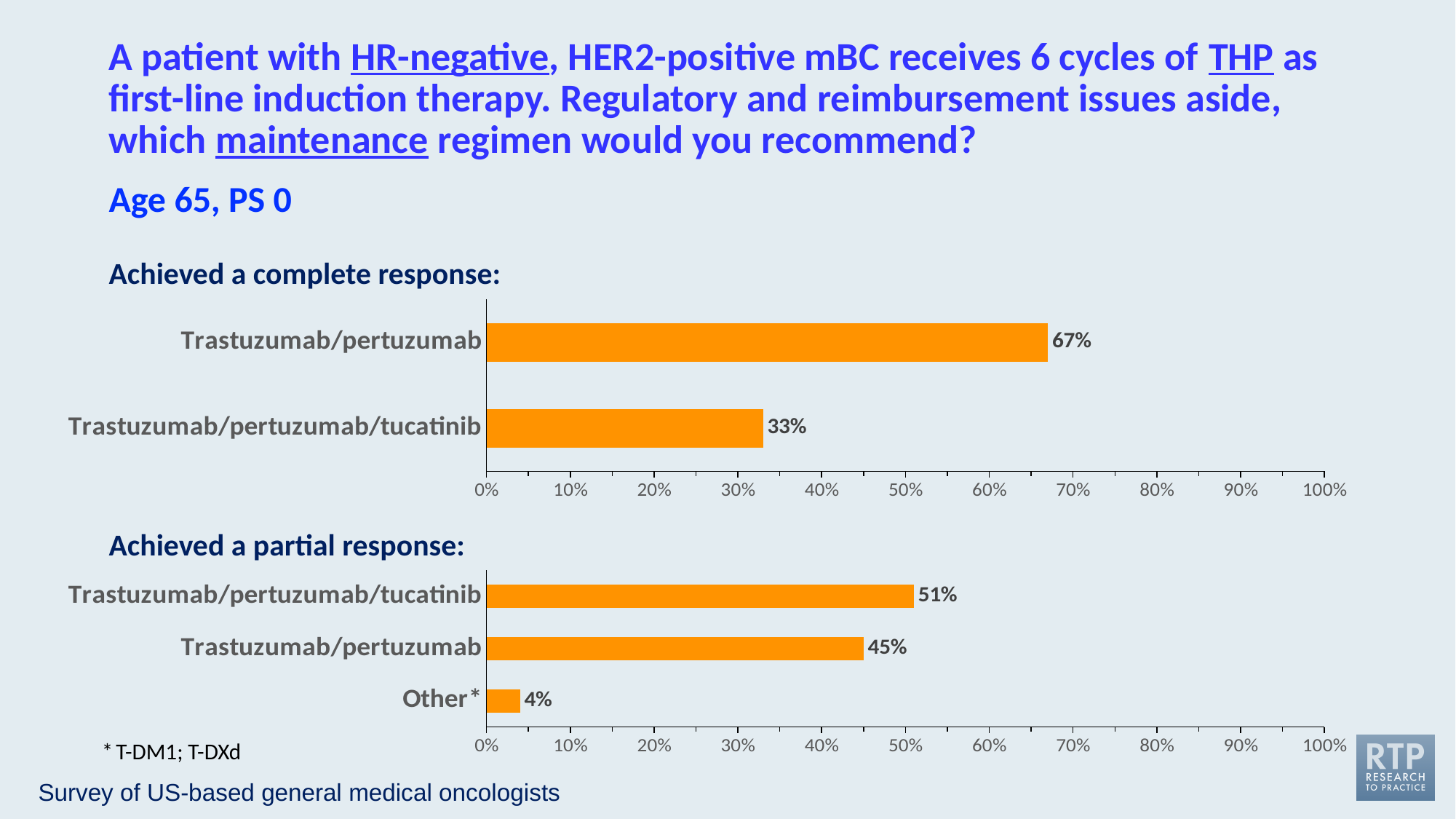
How many categories are shown in the 'Achieved a partial response' chart? 3 In the 'Achieved a complete response' chart, what is the difference between the values for Trastuzumab/pertuzumab and Trastuzumab/pertuzumab/tucatinib? 34% In the 'Achieved a partial response' chart, what percentage chose Trastuzumab/pertuzumab/tucatinib? 51% In the 'Achieved a partial response' chart, what is the value for Other*? 4% What is the maximum value shown on the x axis of the 'Achieved a partial response' chart? 100% In the 'Achieved a partial response' chart, which category has the lowest value? Other* In the 'Achieved a complete response' chart, what percentage of respondents chose Trastuzumab/pertuzumab? 67% In the 'Achieved a partial response' chart, what is the difference between Trastuzumab/pertuzumab/tucatinib and Trastuzumab/pertuzumab? 6% In the 'Achieved a complete response' chart, what is the value for Trastuzumab/pertuzumab/tucatinib? 33% In the 'Achieved a partial response' chart, which category has the highest value? Trastuzumab/pertuzumab/tucatinib In the 'Achieved a complete response' chart, which is larger: Trastuzumab/pertuzumab or Trastuzumab/pertuzumab/tucatinib? Trastuzumab/pertuzumab What type of chart is used in the 'Achieved a complete response' section? Bar chart